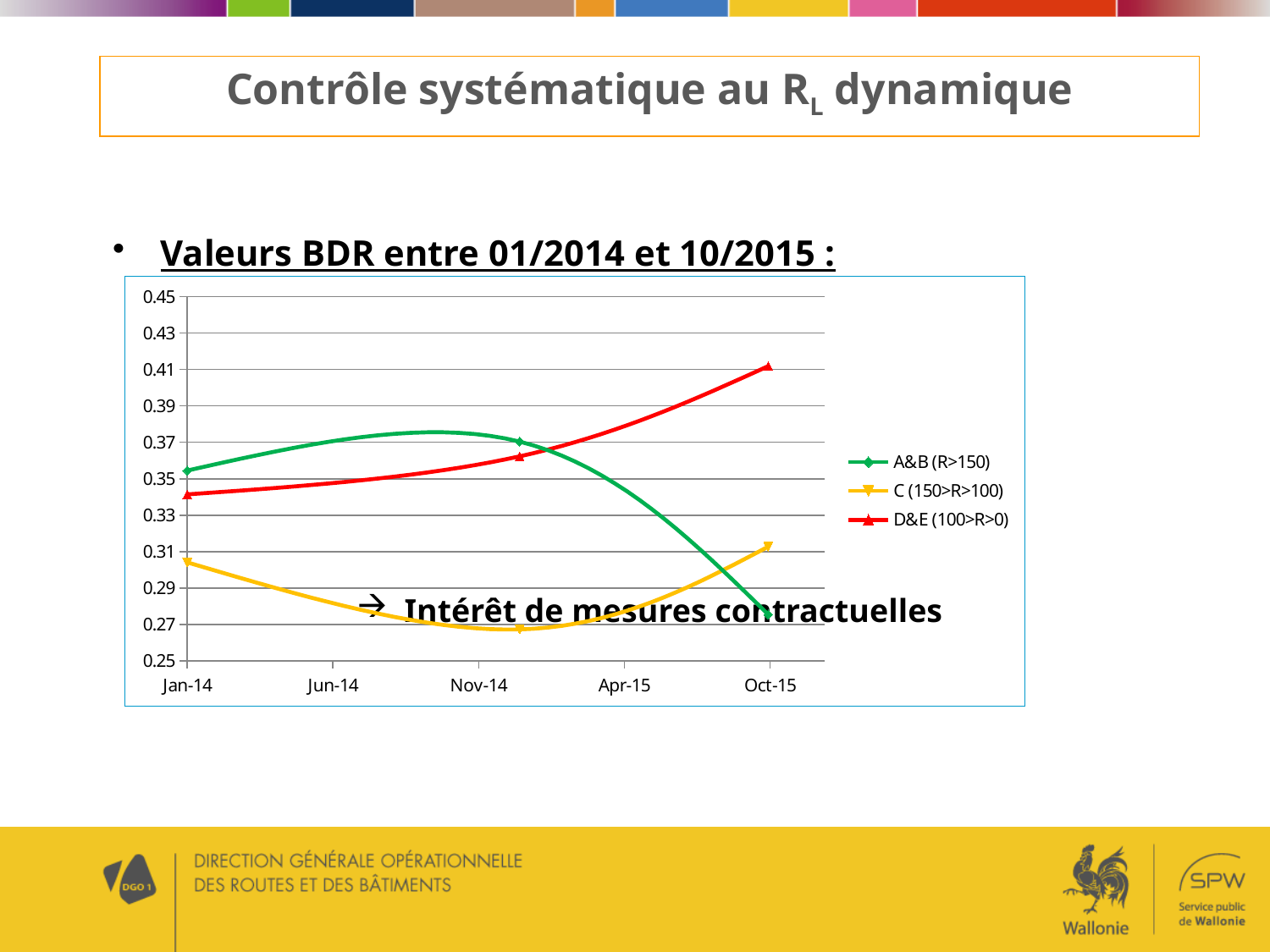
What kind of chart is shown on the slide? line chart Is the value of D&E (100>R>0) at Jan-14 greater or less than 0.35? less Which series has the highest value at Oct-15? D&E (100>R>0) Does the D&E (100>R>0) series rise or fall from Jan-14 to Oct-15? rise What colour is the line for the D&E (100>R>0) series? red Is the value of A&B (R>150) at Oct-15 greater or less than 0.31? less How many date labels are shown on the x axis? 5 Is the value of D&E (100>R>0) at Oct-15 greater or less than 0.39? greater At Jan-14, which series has the larger value: A&B (R>150) or D&E (100>R>0)? A&B (R>150) Which series has the lowest value at Jan-14? C (150>R>100) How many series does the chart legend list? 3